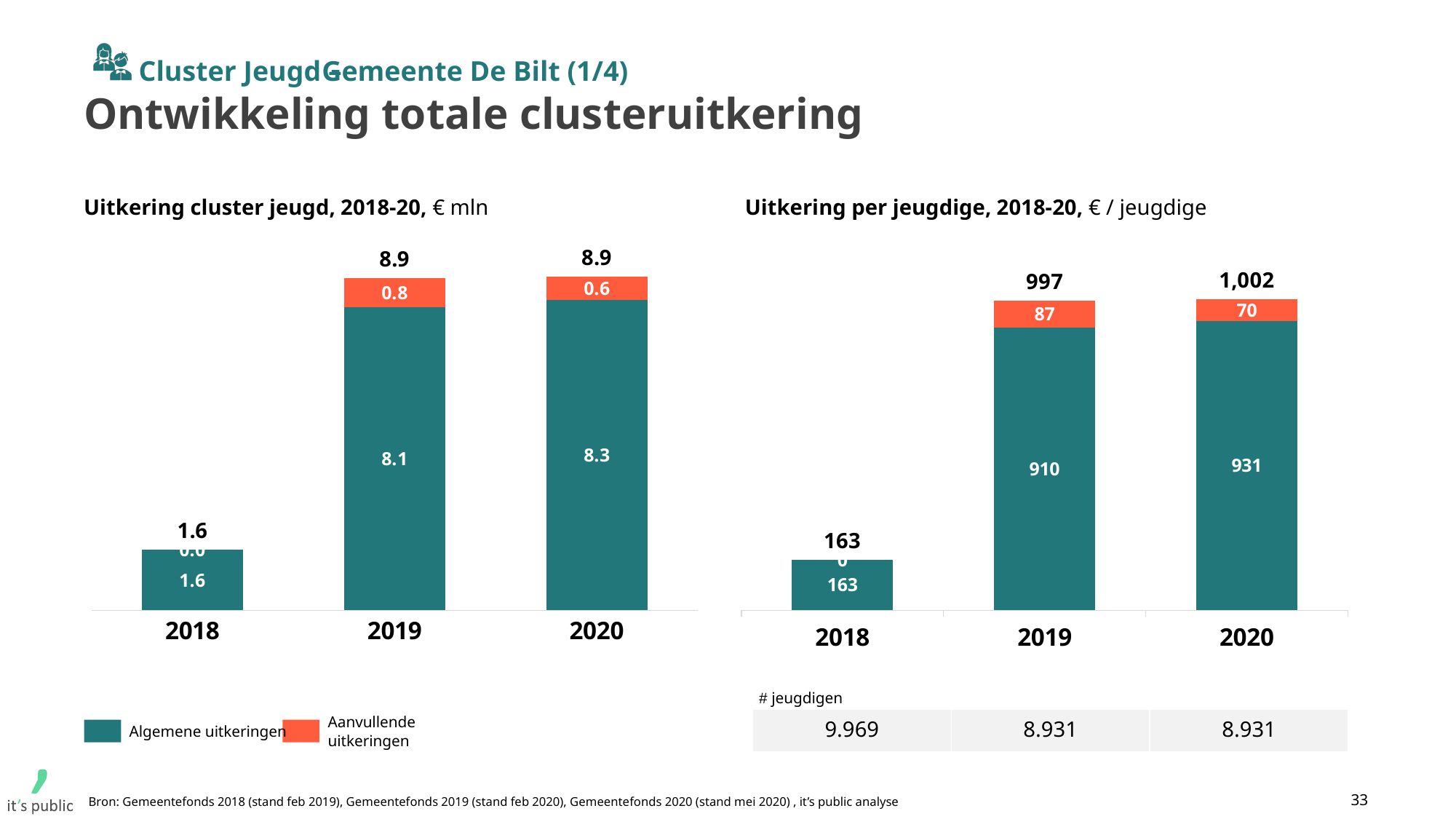
In the chart 'Uitkering cluster jeugd, 2018-20', what is the total of the stacked bar for 2020? 8.9 In the chart 'Uitkering per jeugdige, 2018-20', which year has the highest total uitkering per jeugdige? 2020 In the chart 'Uitkering per jeugdige, 2018-20', what is the total value for 2020? 1,002 In the chart 'Uitkering cluster jeugd, 2018-20', what is the value of Aanvullende uitkeringen for 2019? 0.8 In the chart 'Uitkering cluster jeugd, 2018-20', what is the difference between the Algemene uitkeringen for 2020 and 2019? 0.2 In the chart 'Uitkering cluster jeugd, 2018-20', which year has the lowest total uitkering? 2018 What type of chart is 'Uitkering cluster jeugd, 2018-20'? Stacked bar chart In the chart 'Uitkering per jeugdige, 2018-20', what is the difference between the total for 2019 and the total for 2018? 834 In the chart 'Uitkering cluster jeugd, 2018-20', what is the value of Algemene uitkeringen for 2019? 8.1 In the chart 'Uitkering per jeugdige, 2018-20', what is the value of Aanvullende uitkeringen for 2019? 87 How many series does the legend list for the charts on this slide? 2 In the chart 'Uitkering per jeugdige, 2018-20', is the Aanvullende uitkeringen value larger in 2019 or in 2020? 2019